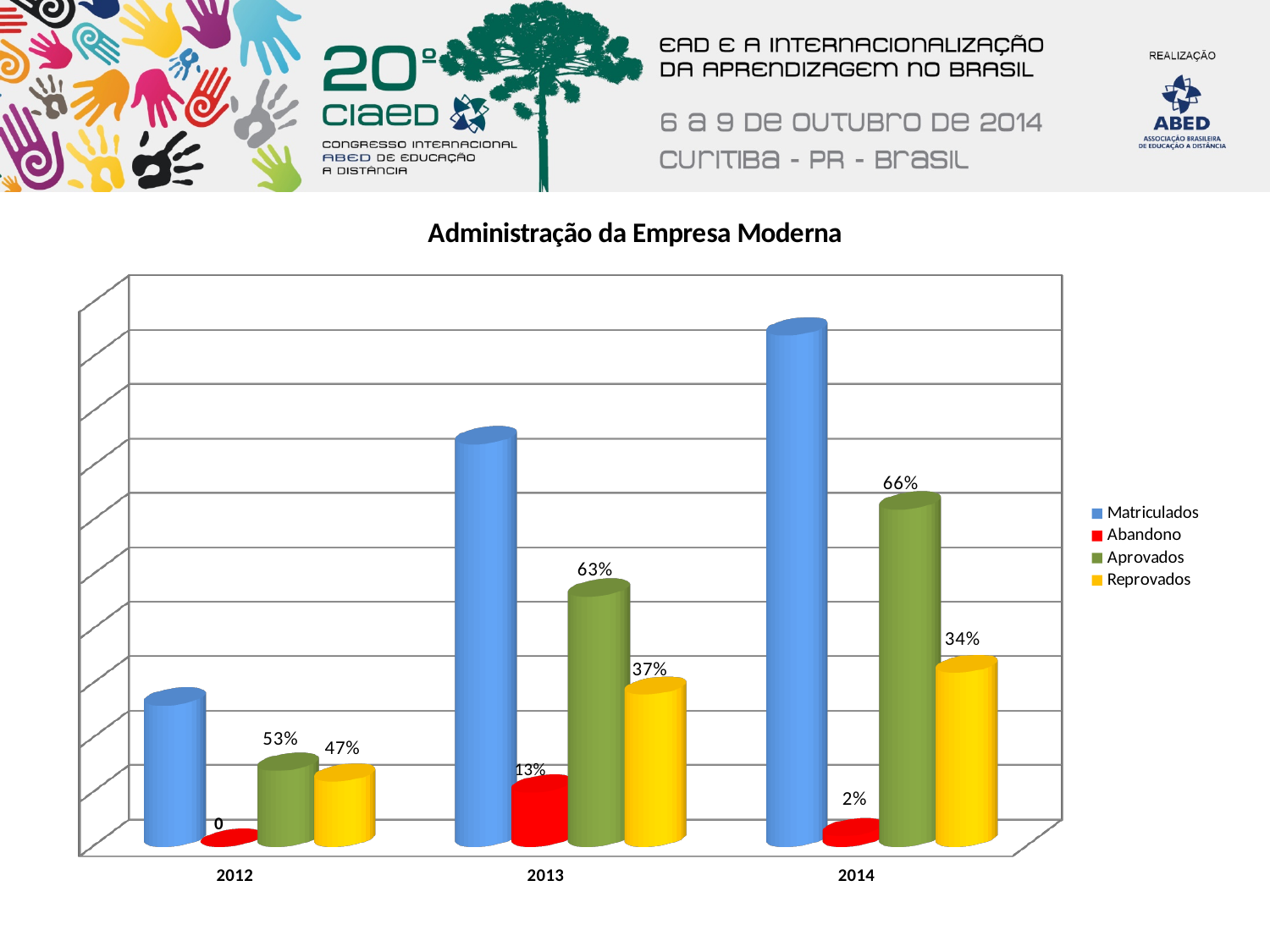
What is the title of the chart? Administração da Empresa Moderna How many years are shown on the x axis? 3 What is the Aprovados value for 2013? 63% Which is larger in 2012, Aprovados or Reprovados? Aprovados What kind of chart is shown on the slide? bar chart In which year is the Aprovados value highest? 2014 How many series does the legend list? 4 What is the Reprovados value for 2014? 34% What is the difference between the Aprovados values for 2014 and 2012? 13% What is the Abandono value for 2013? 13%